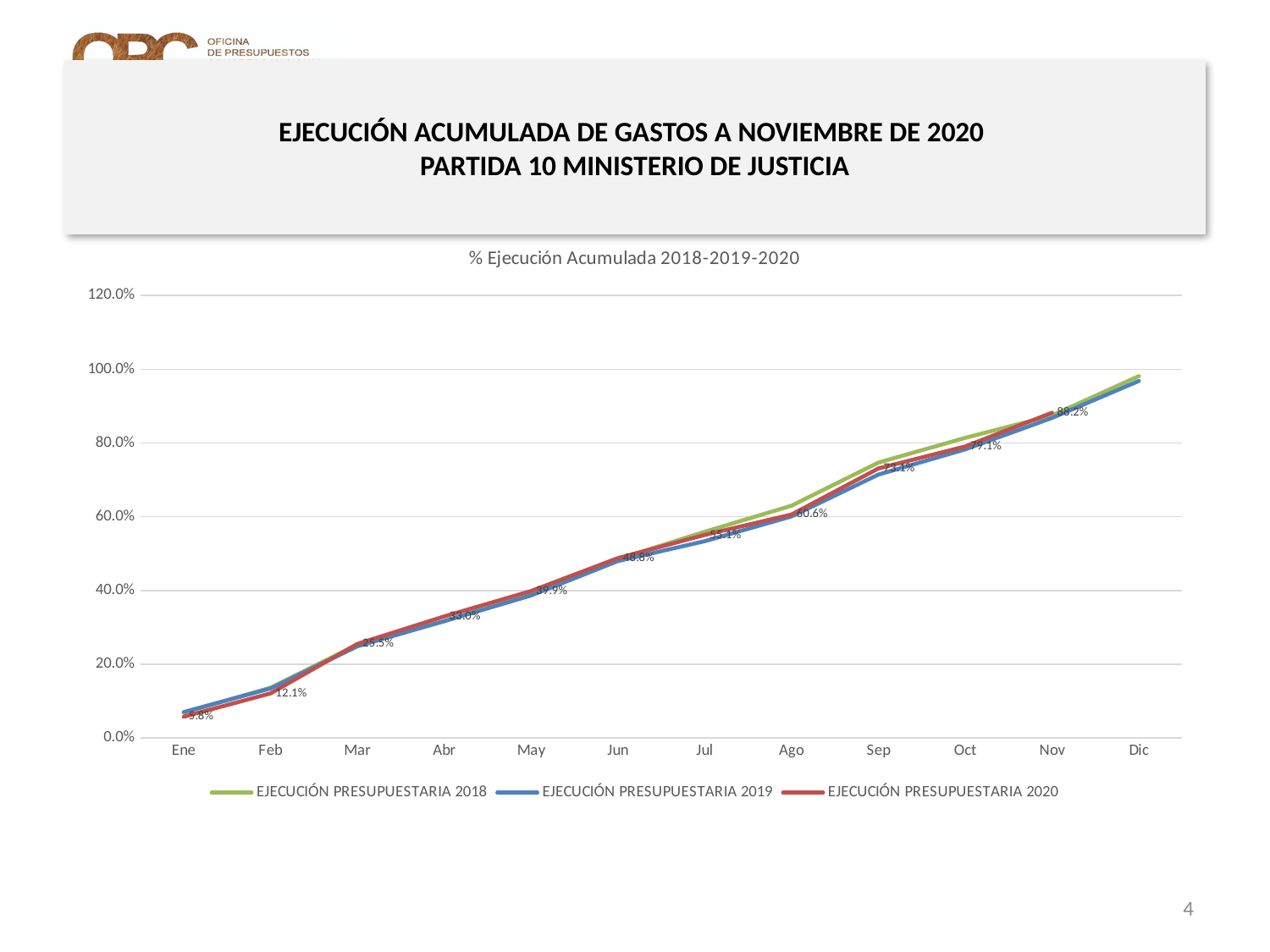
What is the difference between the EJECUCIÓN PRESUPUESTARIA 2020 values for Nov and Oct? 9.1% What kind of chart is shown on the slide? Line chart How many months are shown along the x axis? 12 Is the value for EJECUCIÓN PRESUPUESTARIA 2018 in Dic greater or less than 80.0%? greater What is the title of the chart? % Ejecución Acumulada 2018-2019-2020 What is the value for EJECUCIÓN PRESUPUESTARIA 2020 in Ago? 60.6% What is the value for EJECUCIÓN PRESUPUESTARIA 2020 in Ene? 5.8% What is the value for EJECUCIÓN PRESUPUESTARIA 2020 in Nov? 88.2% What is the value for EJECUCIÓN PRESUPUESTARIA 2020 in Feb? 12.1% What is the value for EJECUCIÓN PRESUPUESTARIA 2020 in Oct? 79.1% Do the values for EJECUCIÓN PRESUPUESTARIA 2020 rise or fall from Ene to Nov? Rise How many series does the legend list? 3